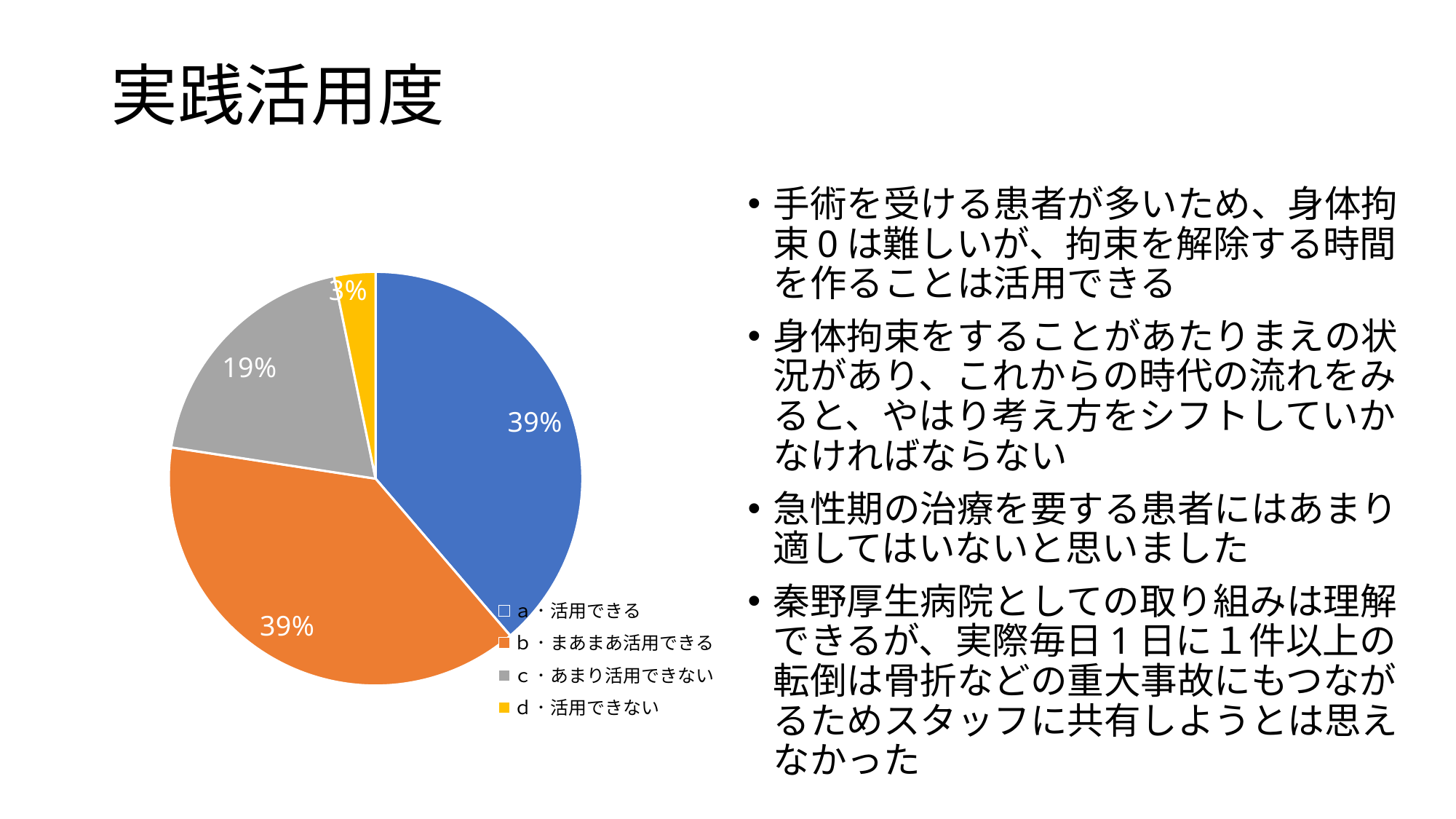
What share of the pie does "c・あまり活用できない" have? 19% What is the difference in percentage points between "a・活用できる" and "c・あまり活用できない"? 20 Which is larger, the slice for "c・あまり活用できない" or the slice for "d・活用できない"? c・あまり活用できない How many categories does the pie chart have? 4 Which is larger, the slice for "a・活用できる" or the slice for "c・あまり活用できない"? a・活用できる What share of the pie does "d・活用できない" have? 3% What is the difference in percentage points between "c・あまり活用できない" and "d・活用できない"? 16 What colour is the slice for "d・活用できない"? yellow What share of the pie does "b・まあまあ活用できる" have? 39% What kind of chart is shown on the slide? pie chart Which category has the smallest slice of the pie? d・活用できない